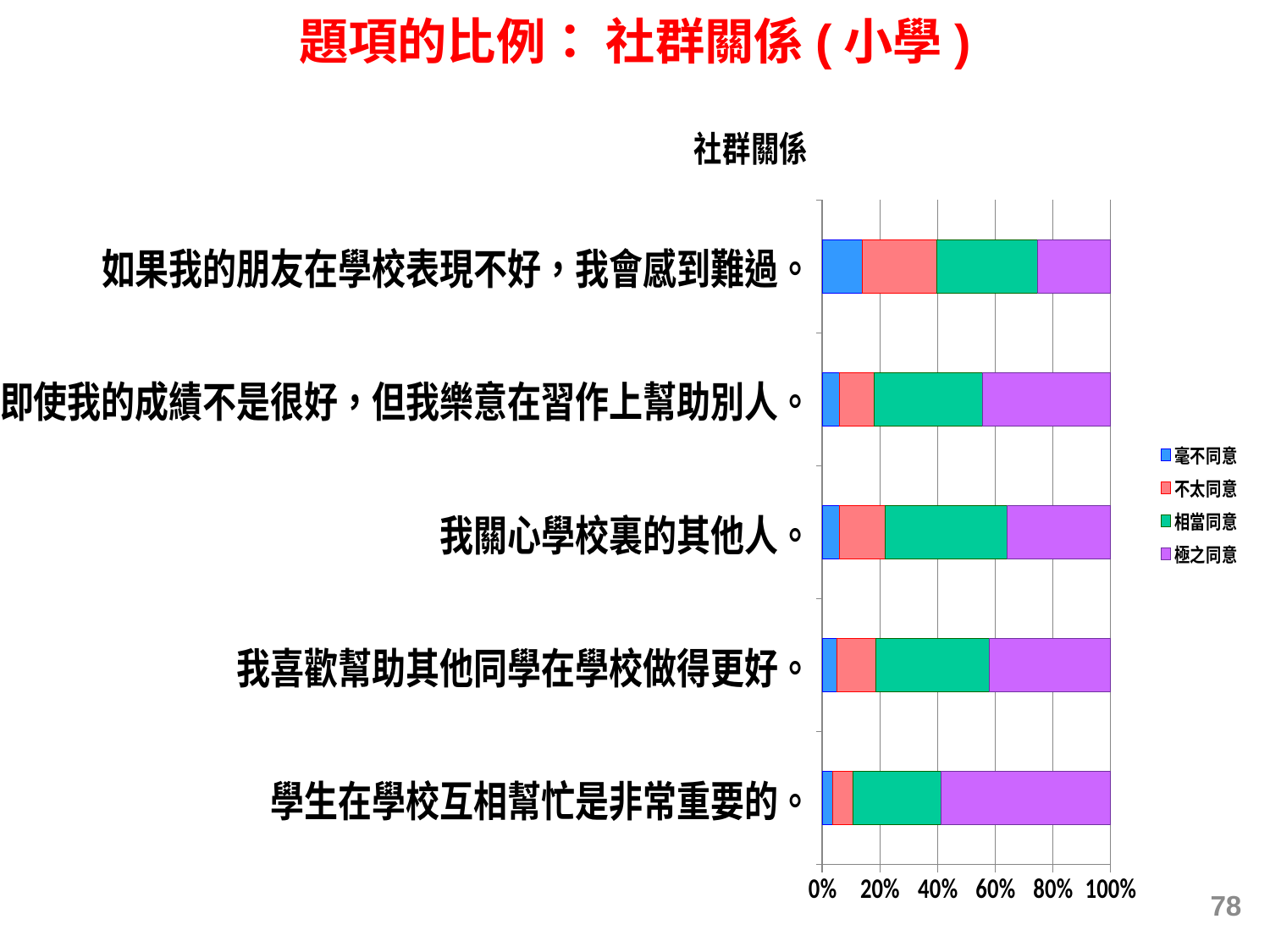
How many series does the legend list? 4 Which item has the largest 毫不同意 segment? 如果我的朋友在學校表現不好，我會感到難過。 Which item has the largest 不太同意 segment? 如果我的朋友在學校表現不好，我會感到難過。 What is the title of the chart? 社群關係 Is the 極之同意 segment for 學生在學校互相幫忙是非常重要的。 larger or smaller than the 極之同意 segment for 我關心學校裏的其他人。? larger Is the 毫不同意 share for 如果我的朋友在學校表現不好，我會感到難過。 greater or less than 20%? less Which item has the smallest 極之同意 segment? 如果我的朋友在學校表現不好，我會感到難過。 How many survey items (categories) are plotted in the chart? 5 Which legend entry is shown in purple? 極之同意 Which item has the largest 極之同意 segment? 學生在學校互相幫忙是非常重要的。 Is the 極之同意 share for 學生在學校互相幫忙是非常重要的。 greater or less than 40%? greater What kind of chart is shown on the slide? Stacked bar chart